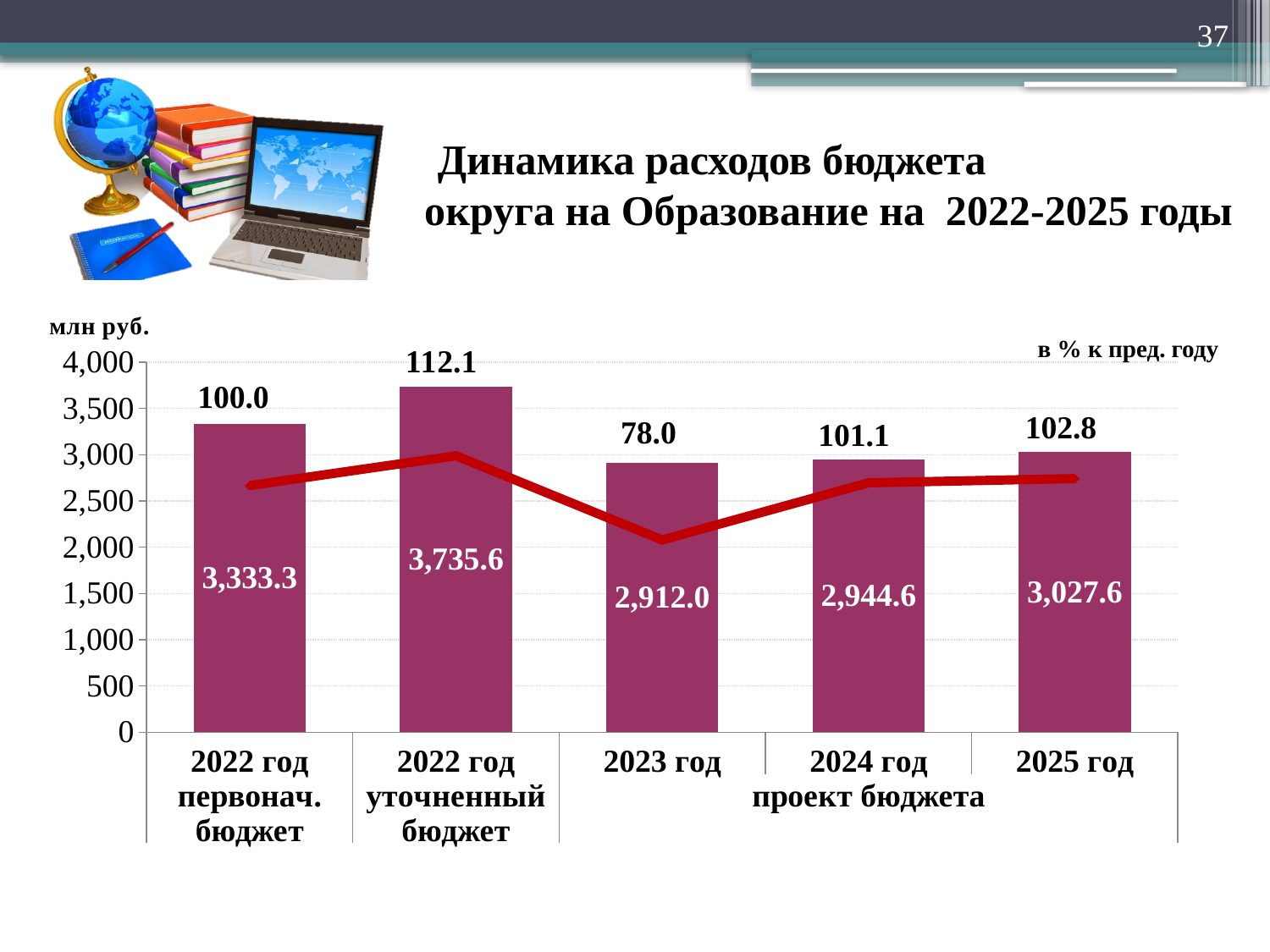
What percentage to the previous year is shown for 2023 год? 78.0 Which is larger, the value for 2024 год or the value for 2025 год? 2025 год What percentage to the previous year is shown above the bar for 2024 год? 101.1 Which category has the lowest bar value in млн руб.? 2023 год What unit label is shown at the top left of the chart's vertical axis? млн руб. Which category has the highest bar value in млн руб.? 2022 год уточненный бюджет What is the budget expenditure value (млн руб.) shown for 2023 год? 2,912.0 Do the bar values rise or fall from 2023 год to 2025 год? Rise How many bars are plotted in the chart? 5 What is the value in млн руб. for 2022 год уточненный бюджет? 3,735.6 What kind of chart is shown on the slide? Bar chart with a line What is the difference in млн руб. between 2022 год уточненный бюджет and 2023 год? 823.6